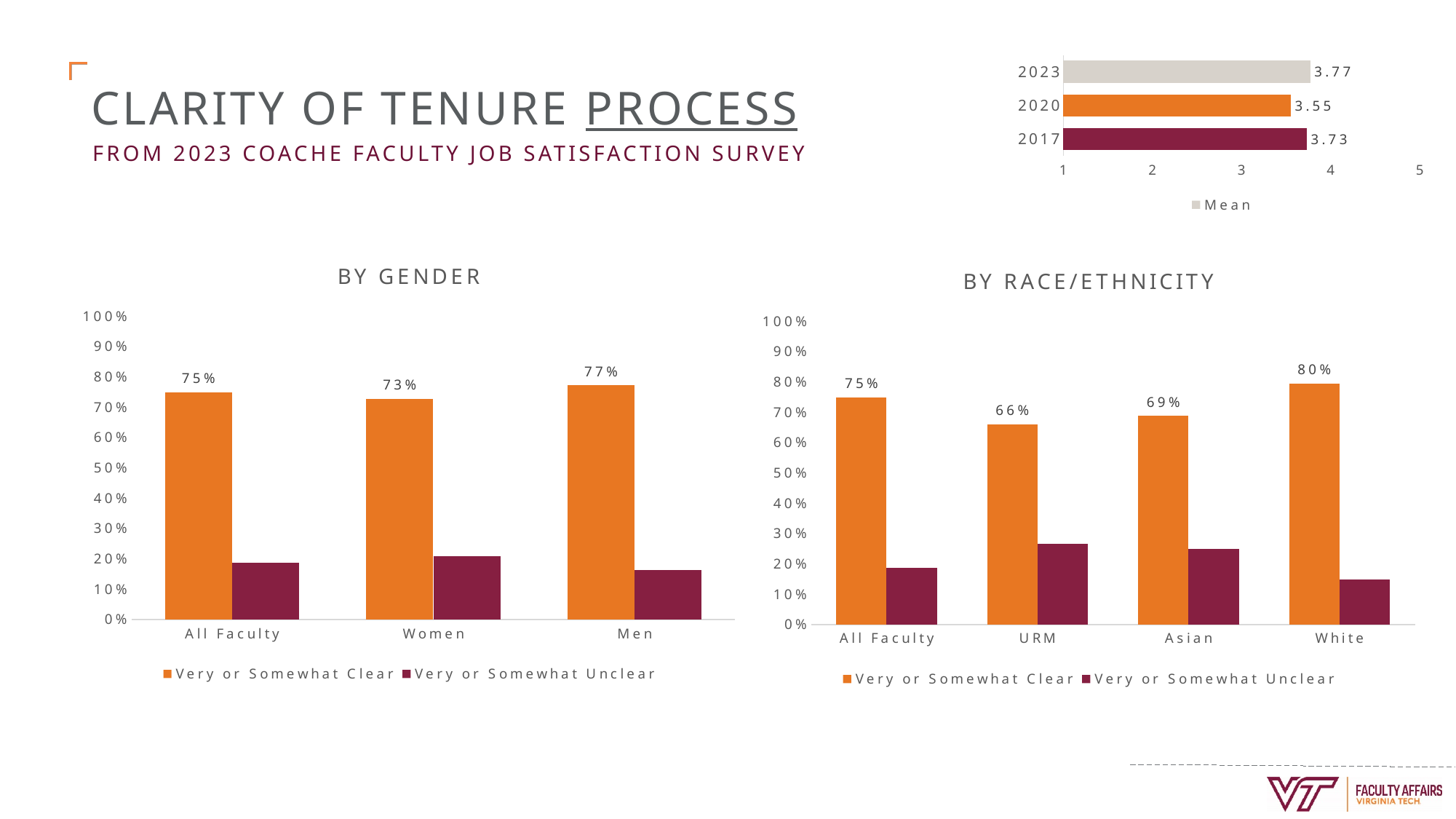
In the By Race/Ethnicity chart, what is the Very or Somewhat Clear value for URM? 66% In the By Gender chart, what is the difference between the Very or Somewhat Clear values for Men and Women? 4% In the By Gender chart, what percentage of Women rated the tenure process Very or Somewhat Clear? 73% In the By Gender chart, which category has the highest Very or Somewhat Clear value? Men In the Mean chart at the top right, how many years are shown? 3 In the Mean chart at the top right, what is the mean value for 2023? 3.77 How many series does the legend of the By Race/Ethnicity chart list? 2 In the Mean chart at the top right, what is the difference between the 2023 mean and the 2020 mean? 0.22 In the By Gender chart, is the Very or Somewhat Unclear value for Men greater or less than 20%? less In the By Race/Ethnicity chart, which category has the highest Very or Somewhat Clear value? White In the Mean chart at the top right, which year has the lowest mean? 2020 In the By Race/Ethnicity chart, is the Very or Somewhat Unclear value for URM greater or less than 20%? greater